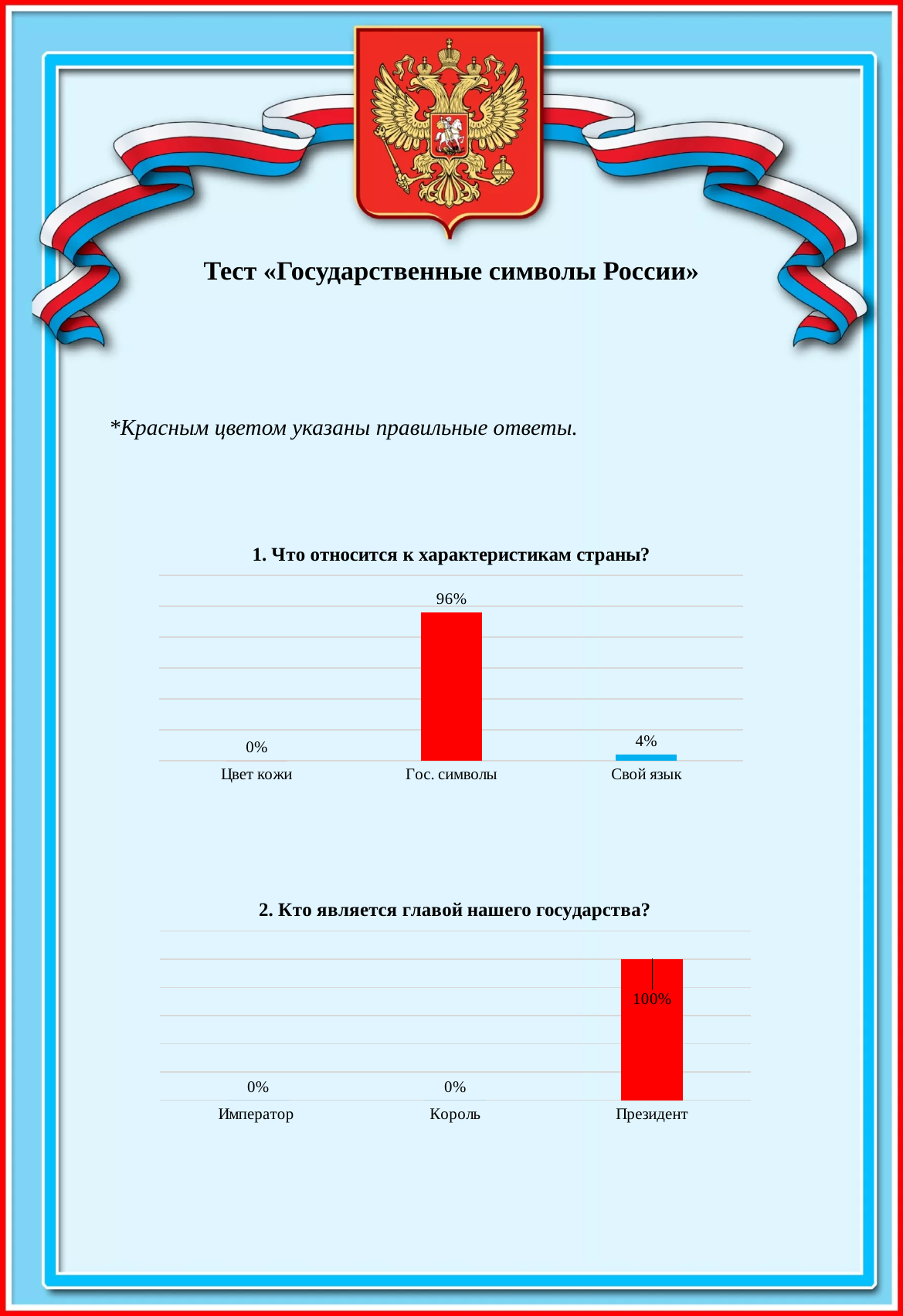
In the chart titled "1. Что относится к характеристикам страны?", what is the value for Цвет кожи? 0% What kind of chart is the chart titled "2. Кто является главой нашего государства?"? bar chart In the chart titled "1. Что относится к характеристикам страны?", what is the difference between the values for Гос. символы and Свой язык? 92% In the chart titled "1. Что относится к характеристикам страны?", what is the value for Гос. символы? 96% In the chart titled "1. Что относится к характеристикам страны?", how many categories are shown? 3 In the chart titled "2. Кто является главой нашего государства?", which category has the highest value? Президент In the chart titled "1. Что относится к характеристикам страны?", what is the value for Свой язык? 4% In the chart titled "2. Кто является главой нашего государства?", what is the value for Президент? 100% In the chart titled "2. Кто является главой нашего государства?", what is the value for Король? 0% In the chart titled "1. Что относится к характеристикам страны?", which category has the highest value? Гос. символы In the chart titled "2. Кто является главой нашего государства?", which is larger, the value for Император or the value for Президент? Президент In the chart titled "1. Что относится к характеристикам страны?", what colour is the bar for Гос. символы? red